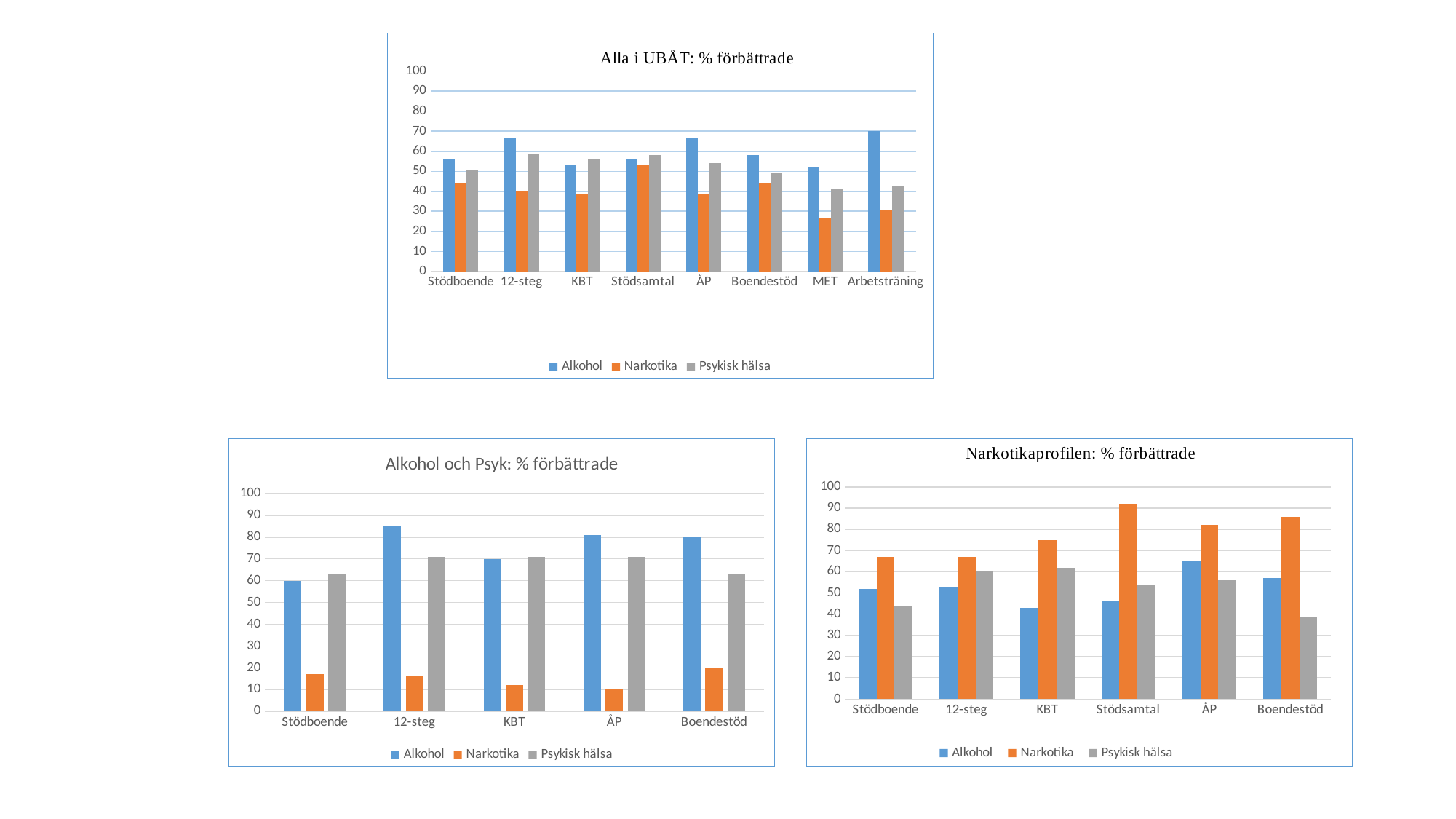
In the chart titled 'Narkotikaprofilen: % förbättrade', which category has the highest Narkotika value? Stödsamtal In the chart titled 'Alla i UBÅT: % förbättrade', is the Alkohol value for Arbetsträning greater or less than 60? greater In the chart titled 'Alkohol och Psyk: % förbättrade', which is larger for Stödboende, the Alkohol value or the Narkotika value? Alkohol In the chart titled 'Alla i UBÅT: % förbättrade', how many categories are shown on the x axis? 8 How many charts are on the slide? 3 In the chart titled 'Alla i UBÅT: % förbättrade', how many series does the legend list? 3 In the chart titled 'Alkohol och Psyk: % förbättrade', how many categories are shown on the x axis? 5 In the chart titled 'Alkohol och Psyk: % förbättrade', is the Narkotika value for KBT greater or less than 20? less In the chart titled 'Narkotikaprofilen: % förbättrade', which category has the lowest Psykisk hälsa value? Boendestöd In the chart titled 'Alla i UBÅT: % förbättrade', which category has the highest Narkotika value? Stödsamtal In the chart titled 'Alla i UBÅT: % förbättrade', which category has the lowest Narkotika value? MET What kind of chart is 'Alkohol och Psyk: % förbättrade'? bar chart